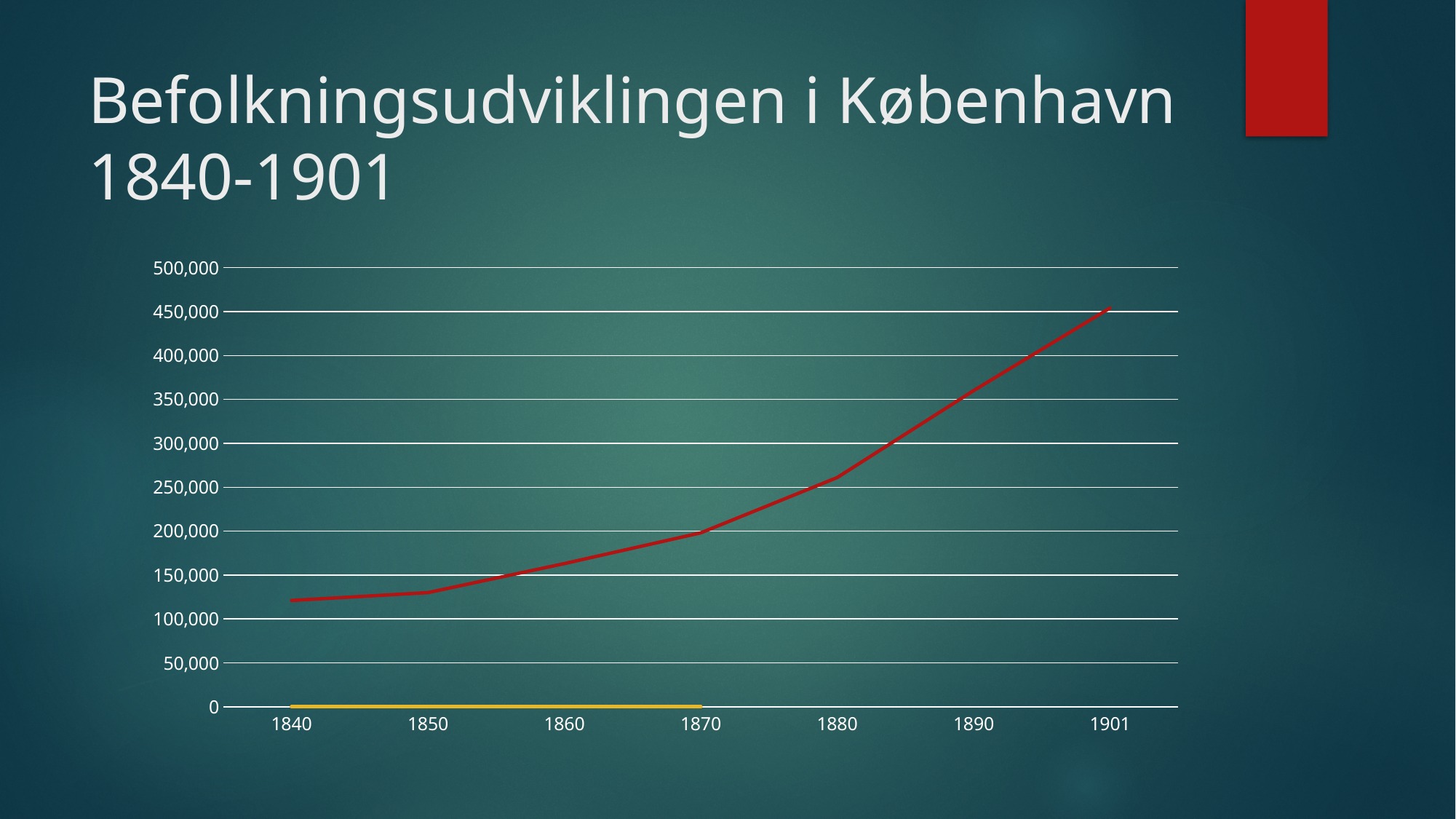
What kind of chart is shown on the slide? line chart Which is larger, the value for 1880 or the value for 1850? 1880 What is the title of the slide? Befolkningsudviklingen i København 1840-1901 Do the values rise or fall from 1840 to 1901? rise What colour is the main line in the chart? red Is the value for 1840 greater or less than 150,000? less Is the value for 1901 greater or less than 400,000? greater Is the value for 1860 greater or less than 200,000? less How many years are marked on the x axis? 7 Which year has the lowest population value? 1840 Which year has the highest population value? 1901